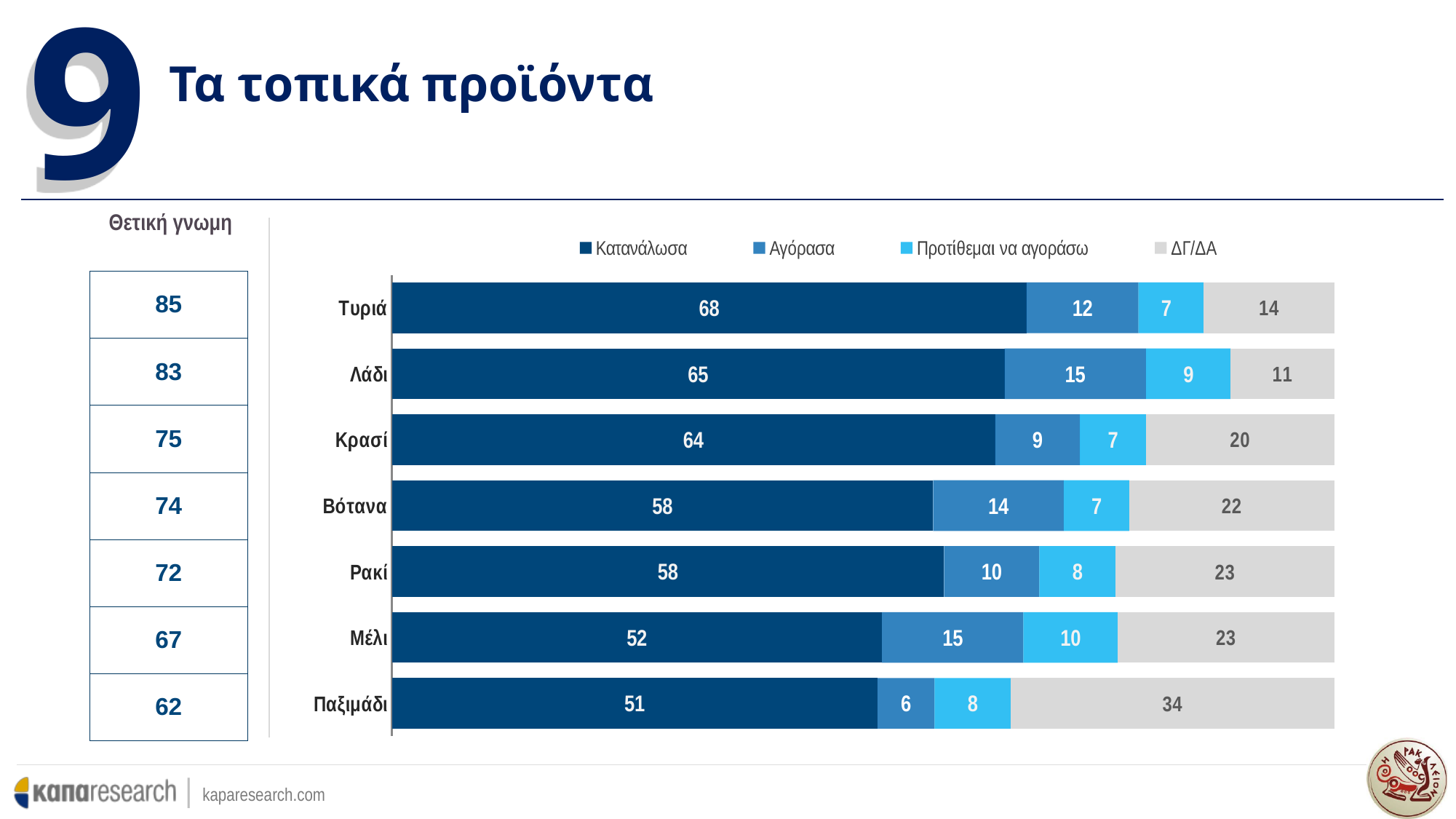
Which category has the lowest Κατανάλωσα value? Παξιμάδι Which category has the highest ΔΓ/ΔΑ value? Παξιμάδι What is the total of the stacked bar for Κρασί? 100 What is the value of Προτίθεμαι να αγοράσω for Μέλι? 10 What is the difference between the Κατανάλωσα values for Τυριά and Παξιμάδι? 17 What is the value of Κατανάλωσα for Λάδι? 65 How many categories are shown in the chart? 7 How many series does the legend list? 4 What is the ΔΓ/ΔΑ value for Παξιμάδι? 34 What kind of chart is shown on the slide? Stacked bar chart Which category has the highest Κατανάλωσα value? Τυριά Which has a larger Αγόρασα value, Λάδι or Κρασί? Λάδι